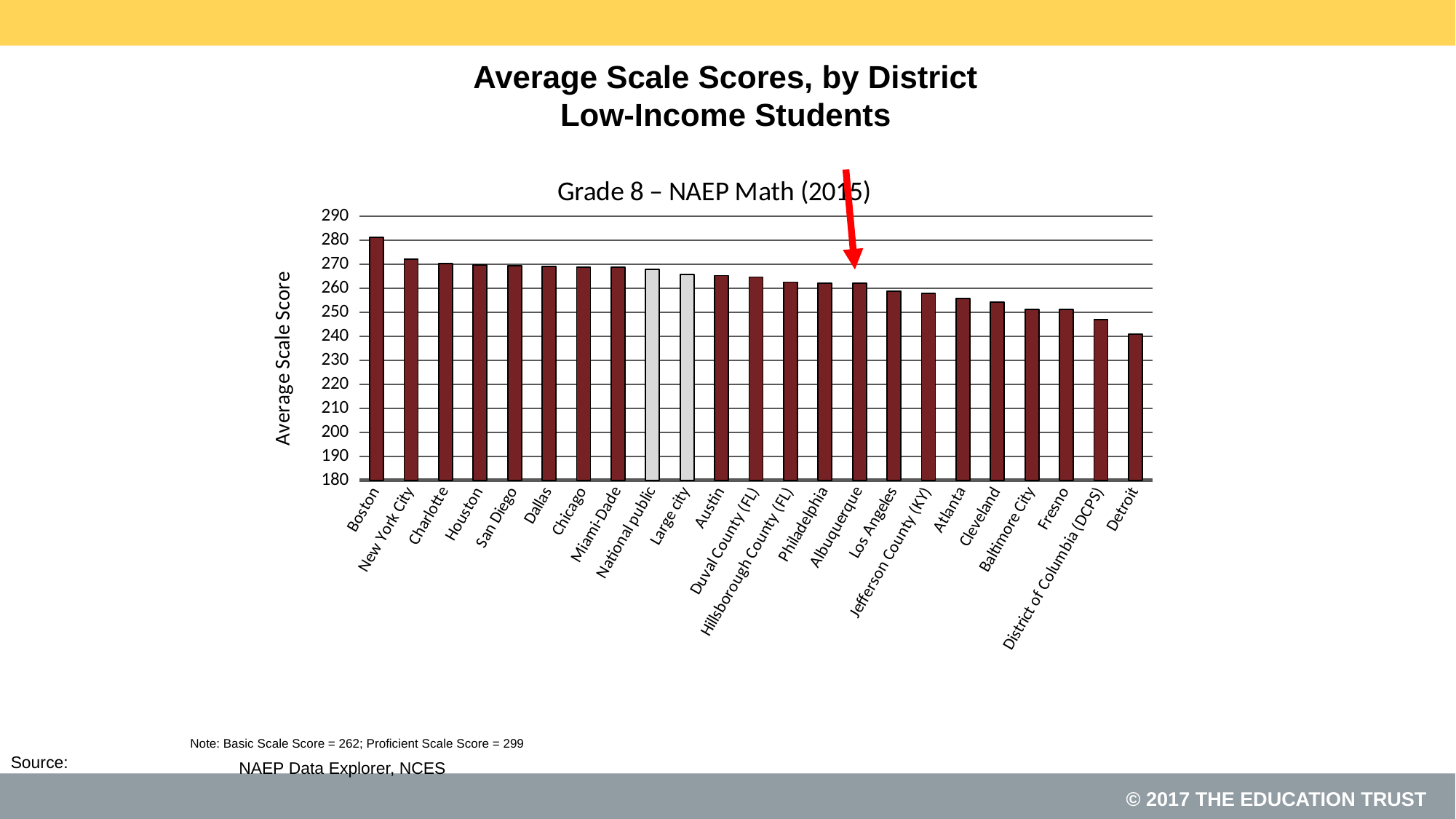
How many districts or groups are plotted on the chart? 23 Is the value for Detroit greater or less than 250? less Which district has the highest average scale score? Boston Is the value for Boston greater or less than 270? greater Which has the larger value, District of Columbia (DCPS) or Detroit? District of Columbia (DCPS) What kind of chart is shown on the slide? bar chart Which district has the lowest average scale score? Detroit Do the bars rise or fall moving from left to right along the x axis? fall Is the value for Atlanta greater or less than 260? less Which has the larger value, Boston or New York City? Boston What is the label on the vertical axis of the chart? Average Scale Score